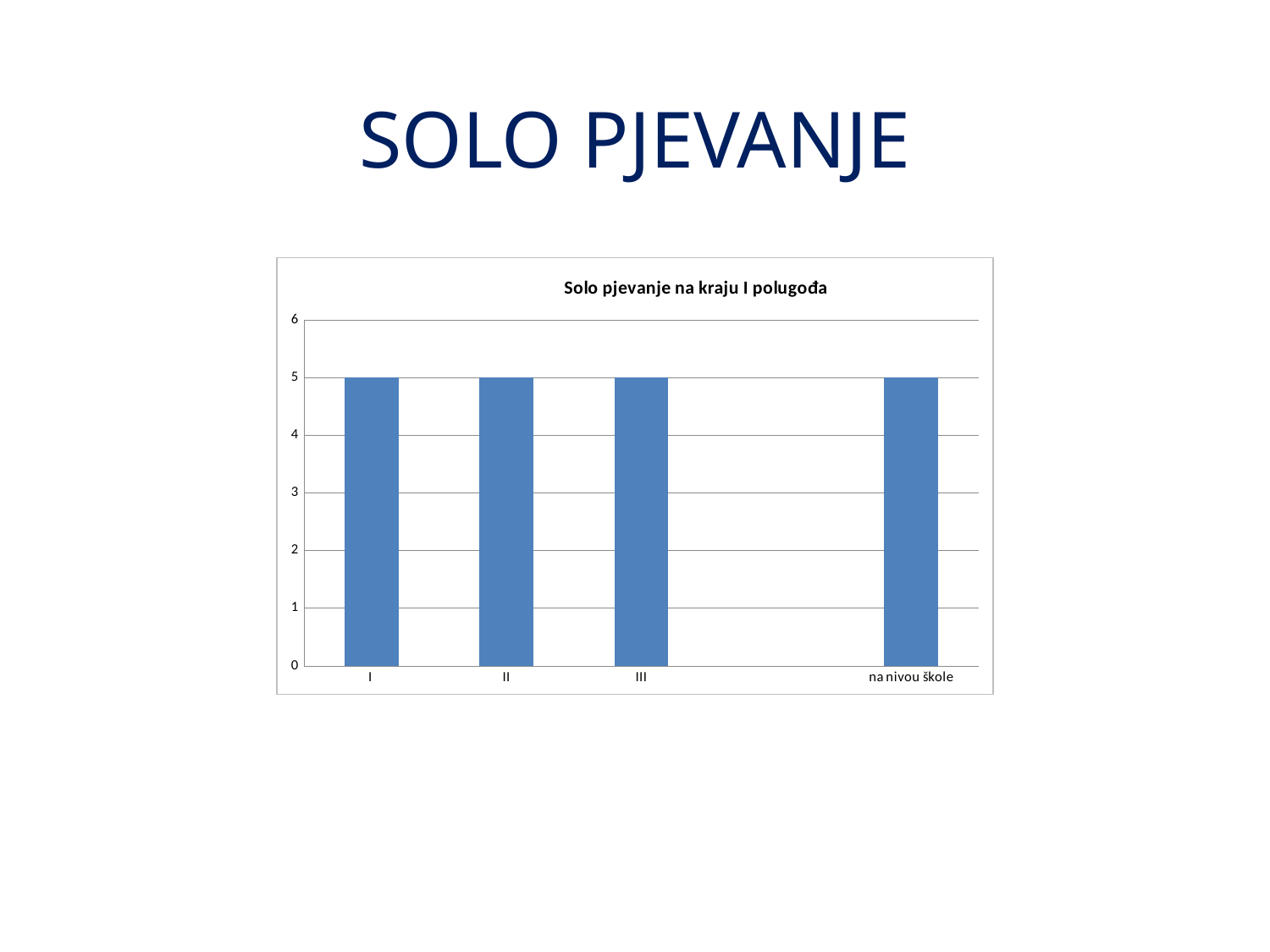
What is the difference between the values for category I and category III? 0 Is the value for 'na nivou škole' greater or less than 6? less How many bars are plotted in the chart? 4 Do the values rise, fall, or stay the same across the categories from I to 'na nivou škole'? stay the same What kind of chart is shown on the slide? bar chart Is the value for category I greater or less than 4? greater What is the value for category II? 5 What is the value for 'na nivou škole'? 5 What is the value for category I? 5 What is the highest value shown on the vertical axis? 6 What is the title of the chart? Solo pjevanje na kraju I polugođa What is the value for category III? 5